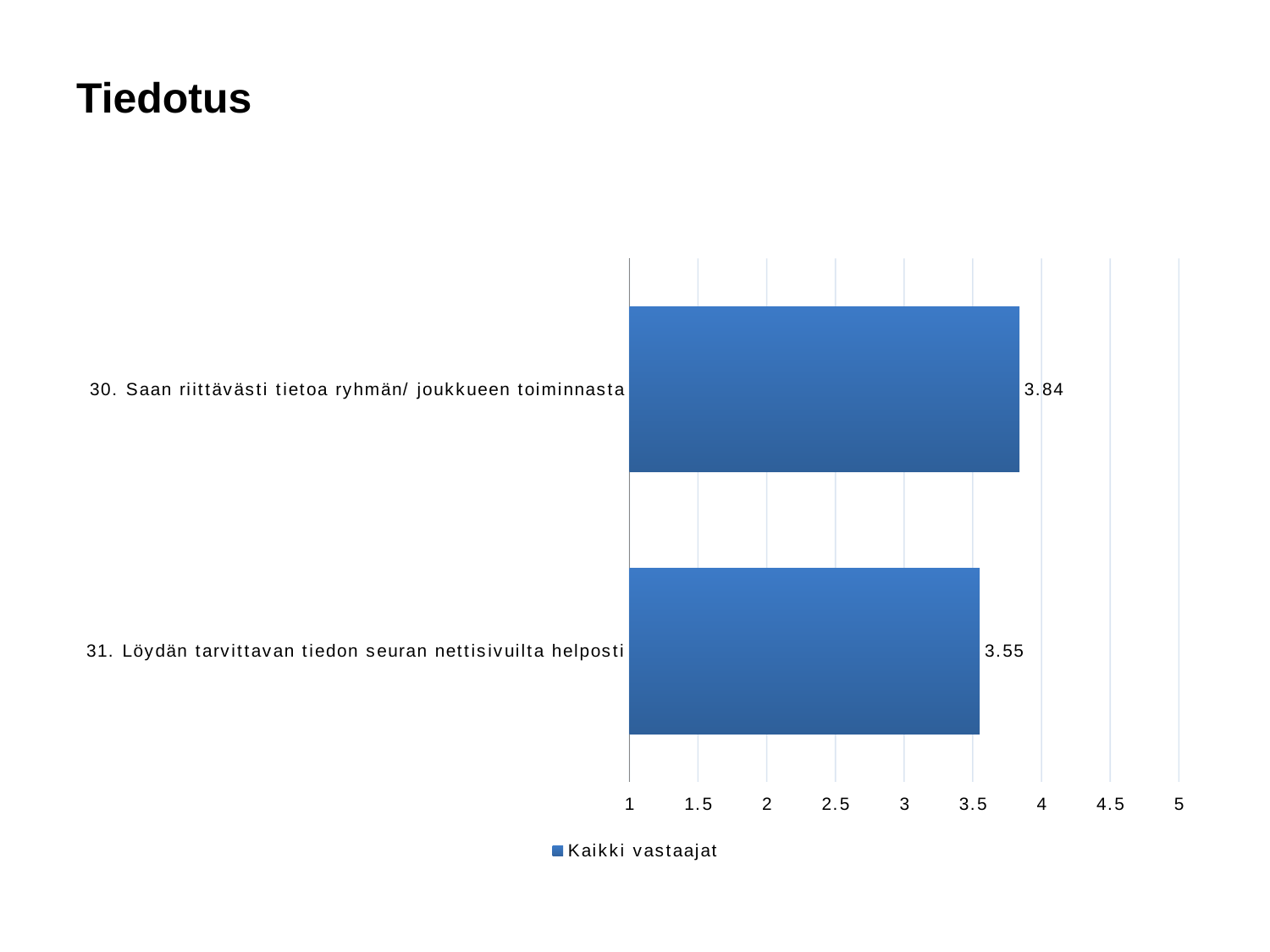
What is the difference between the values for item 30 and item 31? 0.29 How many categories are shown in the chart? 2 What is the name of the series in the legend? Kaikki vastaajat What is the value for "30. Saan riittävästi tietoa ryhmän/ joukkueen toiminnasta"? 3.84 How many series does the legend list? 1 Which category has the lowest value? 31. Löydän tarvittavan tiedon seuran nettisivuilta helposti What kind of chart is shown on the slide? bar chart Which category has the highest value? 30. Saan riittävästi tietoa ryhmän/ joukkueen toiminnasta Is the value for item 30 greater or less than 3.5? greater What is the value for "31. Löydän tarvittavan tiedon seuran nettisivuilta helposti"? 3.55 Which has a larger value, item 30 or item 31? 30. Saan riittävästi tietoa ryhmän/ joukkueen toiminnasta Is the value for item 31 greater or less than 4? less